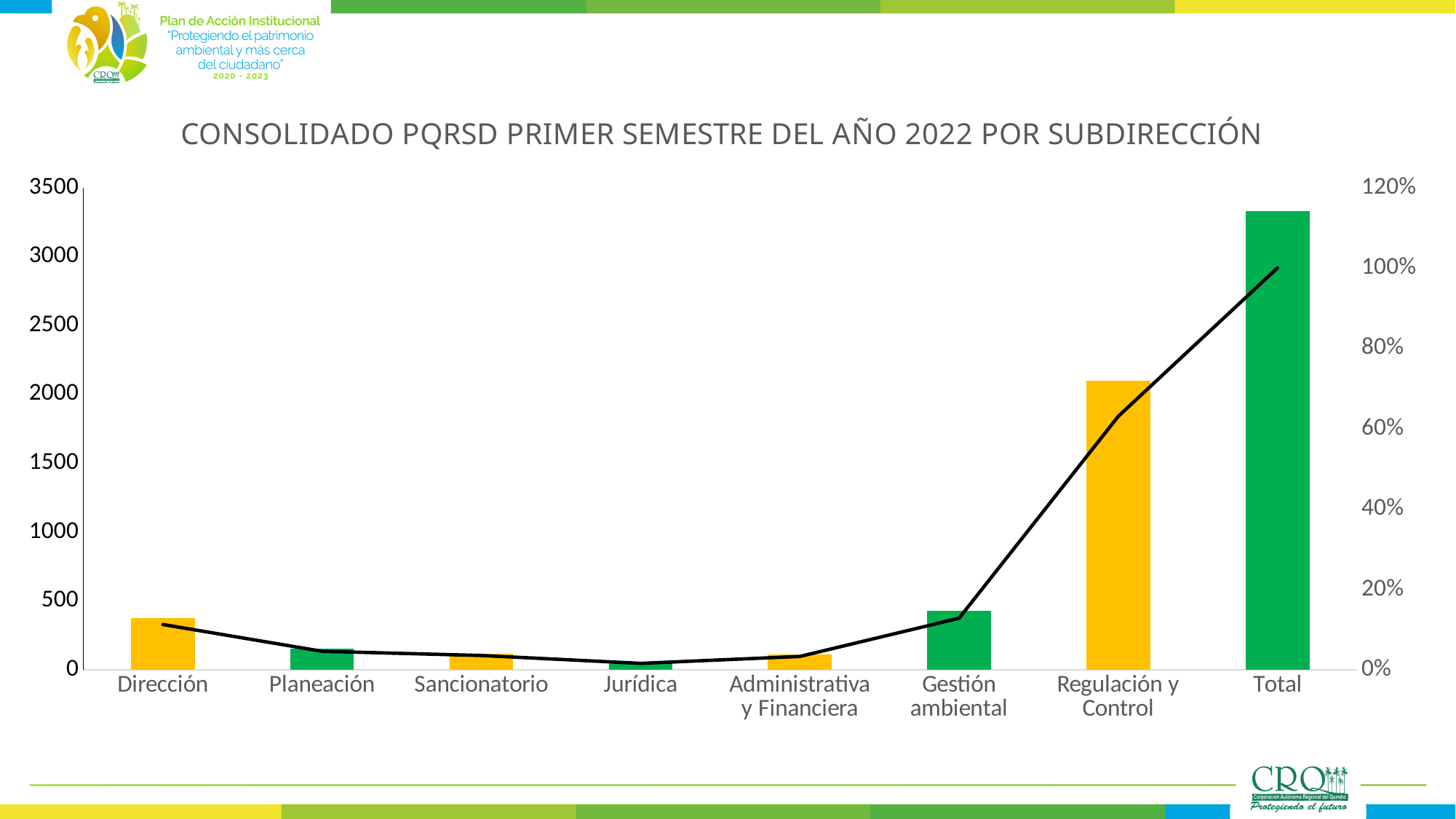
Which bar is taller, Regulación y Control or Gestión ambiental? Regulación y Control Is the bar value for Regulación y Control greater or less than 2000? greater What is the title of the chart? CONSOLIDADO PQRSD PRIMER SEMESTRE DEL AÑO 2022 POR SUBDIRECCIÓN Is the line value for Total greater or less than 80%? greater Which bar is taller, Dirección or Planeación? Dirección What kind of chart is shown on the slide? A bar chart combined with a line How many categories are shown on the x axis? 8 Which category has the shortest bar? Jurídica Which category has the tallest bar? Total Does the line rise or fall between Gestión ambiental and Total? rise Is the bar value for Dirección greater or less than 500? less